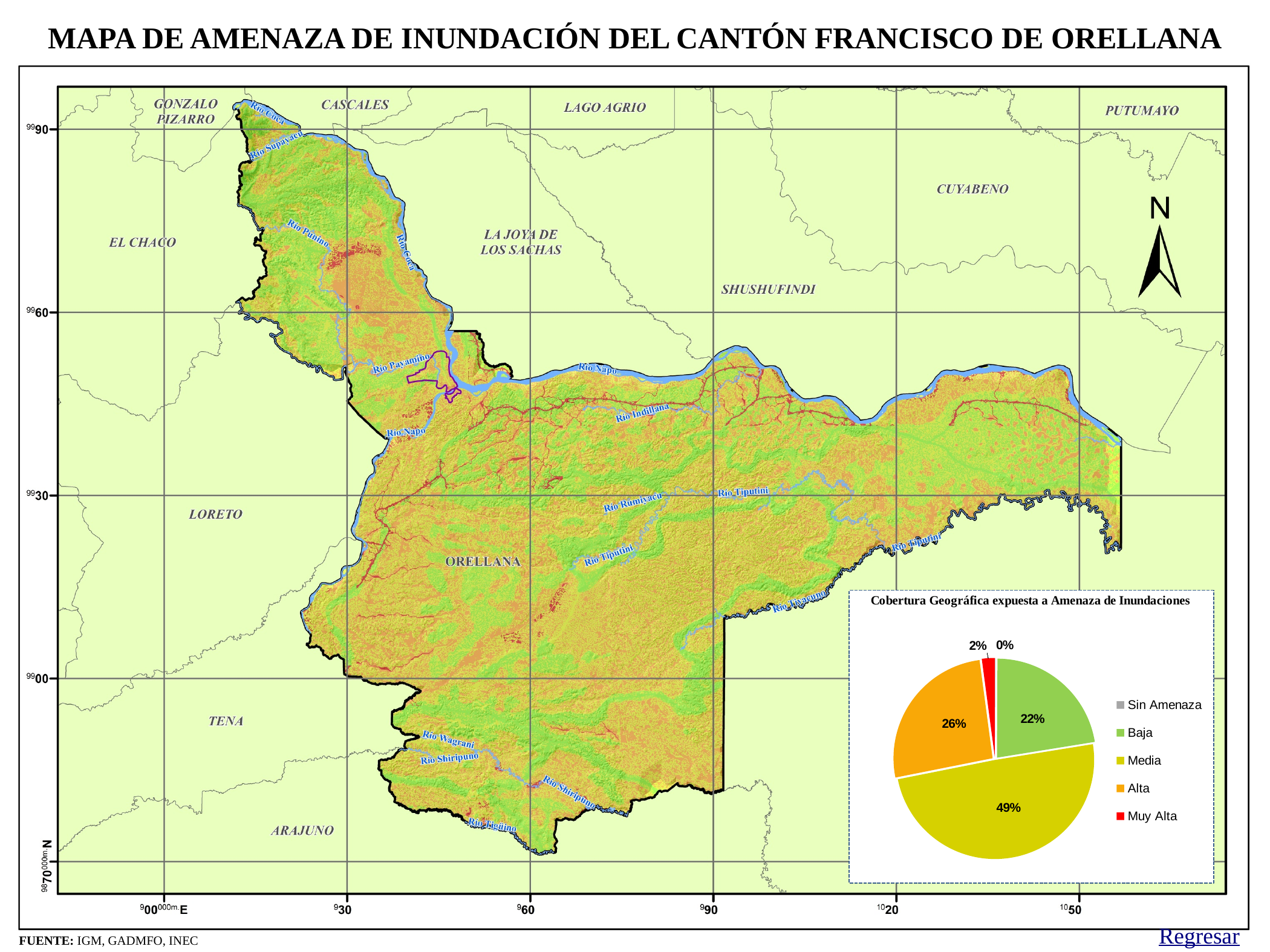
What is the difference in percentage points between the Media and Alta slices in the pie chart? 23 In the pie chart, what share is labelled for Sin Amenaza? 0% In the pie chart, what share is labelled for Baja? 22% Which category has the largest slice in the pie chart? Media Which category has the smallest slice in the pie chart? Sin Amenaza In the pie chart, which is larger, the Alta slice or the Baja slice? Alta What kind of chart is shown in the inset on the slide? Pie chart In the pie chart, what share is labelled for Muy Alta? 2% In the pie chart, what share is labelled for Media? 49% In the pie chart, what share is labelled for Alta? 26% What is the title of the pie chart on the slide? Cobertura Geográfica expuesta a Amenaza de Inundaciones How many categories does the legend of the pie chart list? 5